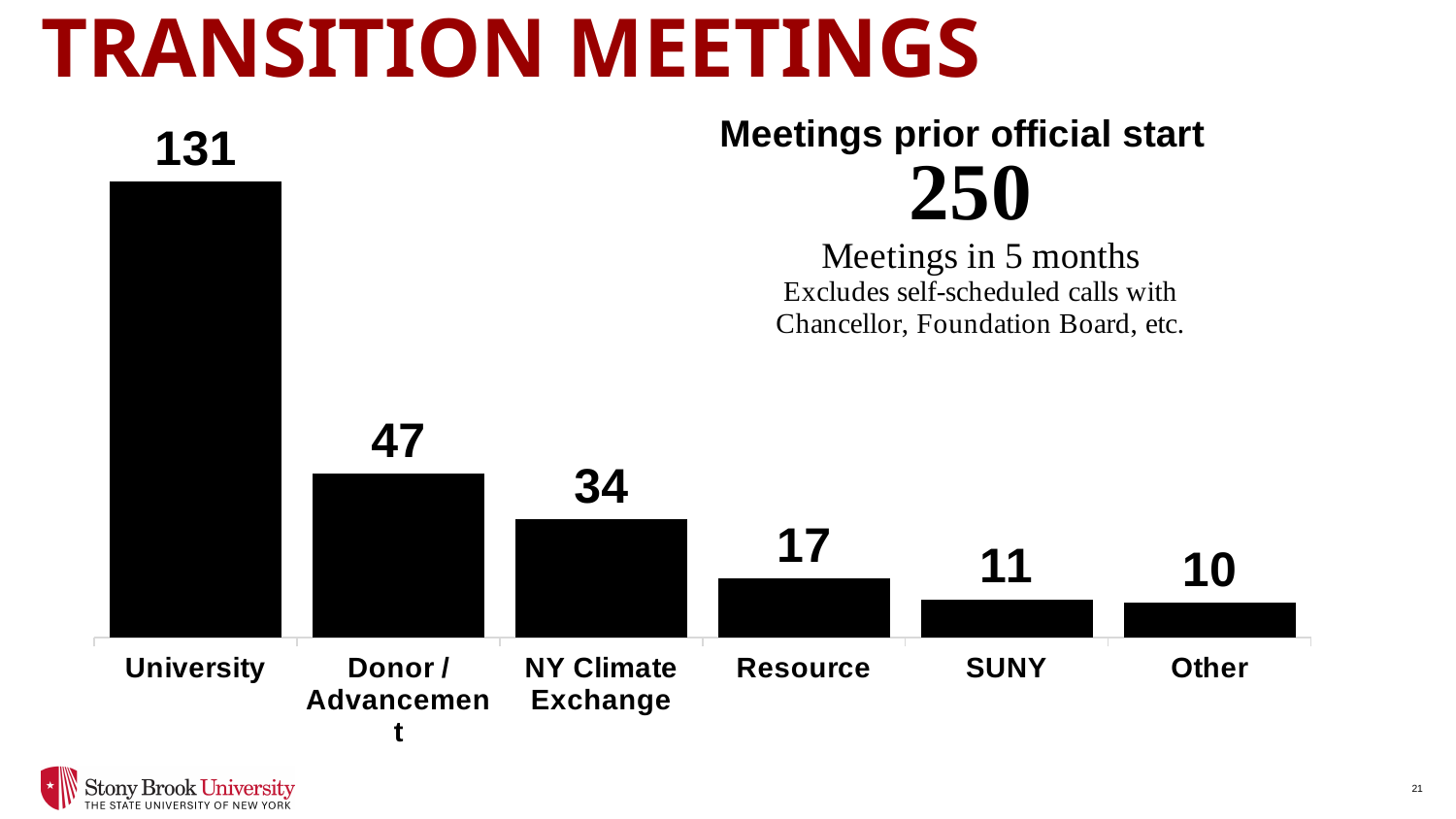
Which category has the lowest value? Other What is the value for Donor / Advancement? 47 What is the value for University? 131 How many categories are shown in the chart? 6 What is the difference between the values for Resource and SUNY? 6 Do the values rise or fall from left to right along the x axis? Fall What kind of chart is shown on the slide? Bar chart What is the difference between the values for University and Donor / Advancement? 84 Which is larger, the value for NY Climate Exchange or the value for Resource? NY Climate Exchange What is the value for SUNY? 11 What is the value for NY Climate Exchange? 34 Which category has the highest value? University